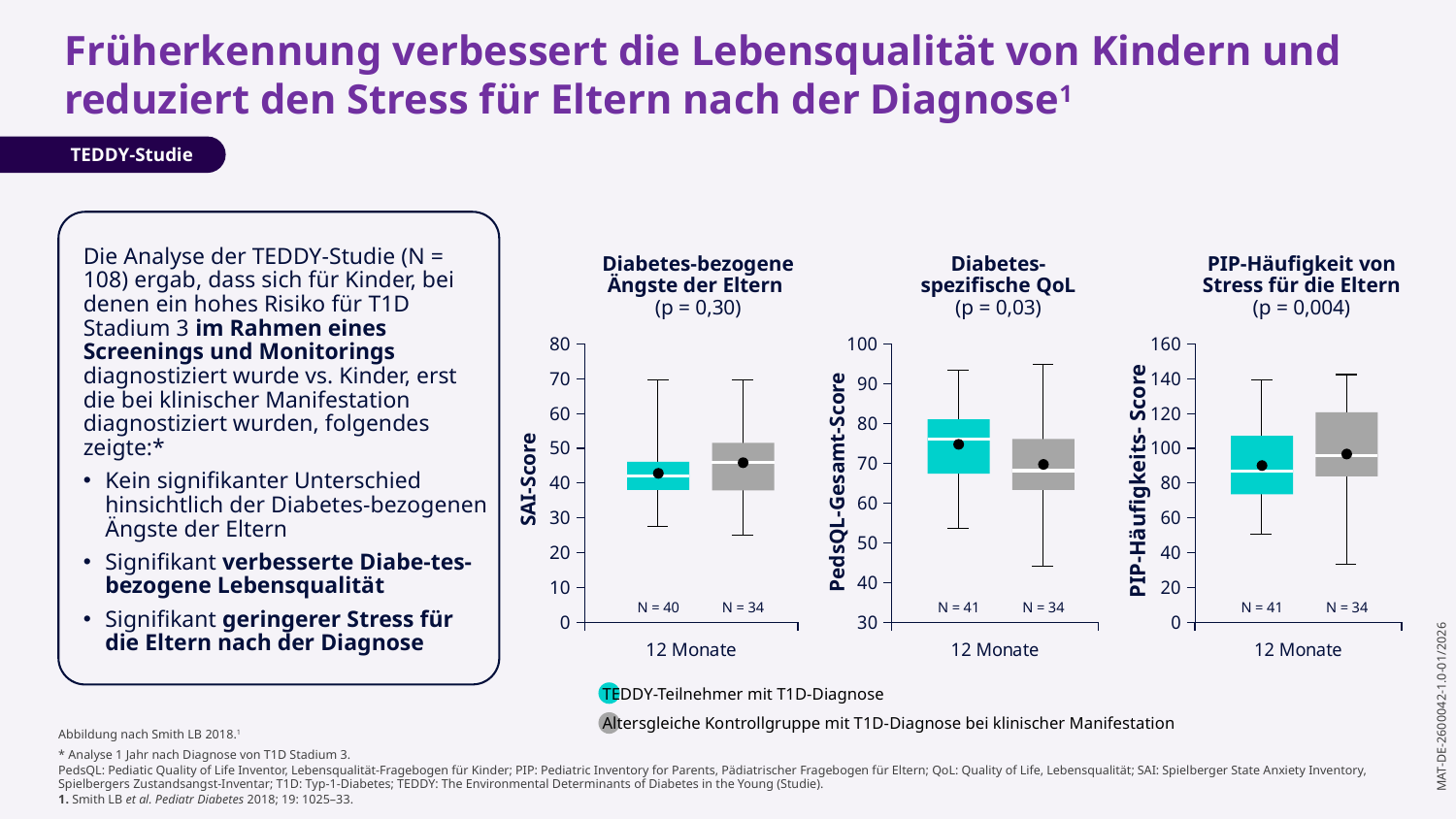
How many groups does the legend below the charts list? 2 What p-value is shown for the chart 'Diabetes-spezifische QoL'? p = 0,03 What is the y-axis label of the middle chart? PedsQL-Gesamt-Score In the chart 'Diabetes-bezogene Ängste der Eltern', what is the N for the TEDDY participants (teal box)? N = 40 In the chart 'Diabetes-spezifische QoL', is the mean (dot) for the TEDDY participants greater or less than 70? greater In the chart 'Diabetes-bezogene Ängste der Eltern', is the mean (dot) for the TEDDY participants greater or less than 50? less In the chart 'PIP-Häufigkeit von Stress für die Eltern', what is the N for the TEDDY participants (teal box)? N = 41 What p-value is shown for the chart 'PIP-Häufigkeit von Stress für die Eltern'? p = 0,004 In the chart 'Diabetes-spezifische QoL', what is the N for the age-matched control group (grey box)? N = 34 In the chart 'PIP-Häufigkeit von Stress für die Eltern', is the mean (dot) for the TEDDY participants greater or less than 100? less What kind of chart is used for the three plots on the slide? Box plot In the chart 'Diabetes-spezifische QoL', which group has the higher mean (dot): the TEDDY participants or the control group? TEDDY participants